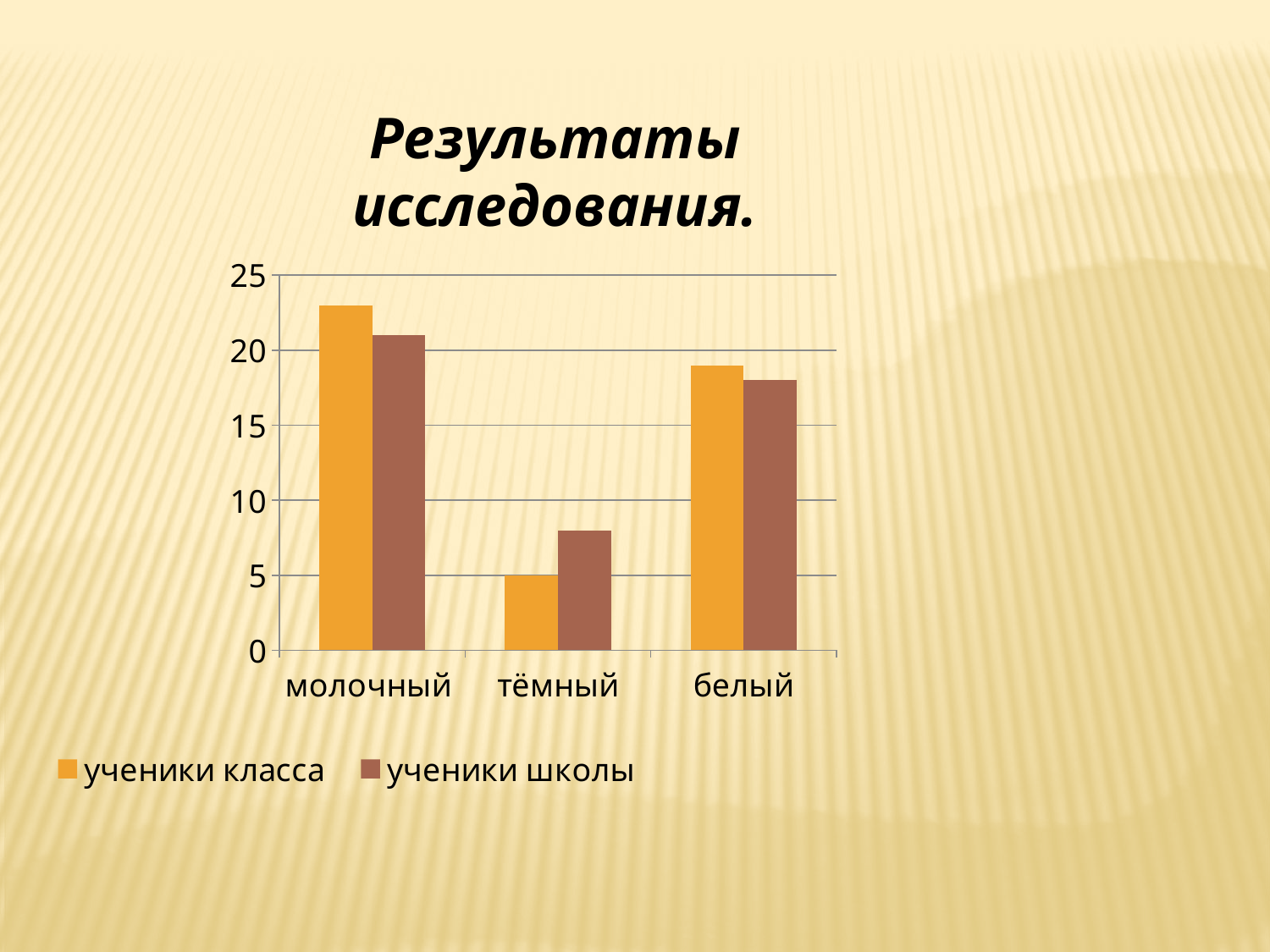
For тёмный, which series has the larger value: ученики класса or ученики школы? ученики школы What is the value for тёмный in the ученики класса series? 5 How many categories are shown on the x axis? 3 What kind of chart is shown on the slide? bar chart Is the value for белый in the ученики школы series greater or less than 20? less What is the title of the chart? Результаты исследования. Which category has the highest value for ученики класса? молочный Which category has the lowest value for ученики класса? тёмный For молочный, which series has the larger value: ученики класса or ученики школы? ученики класса Is the value for молочный in the ученики класса series greater or less than 20? greater How many series does the legend list? 2 Which category has the lowest value for ученики школы? тёмный